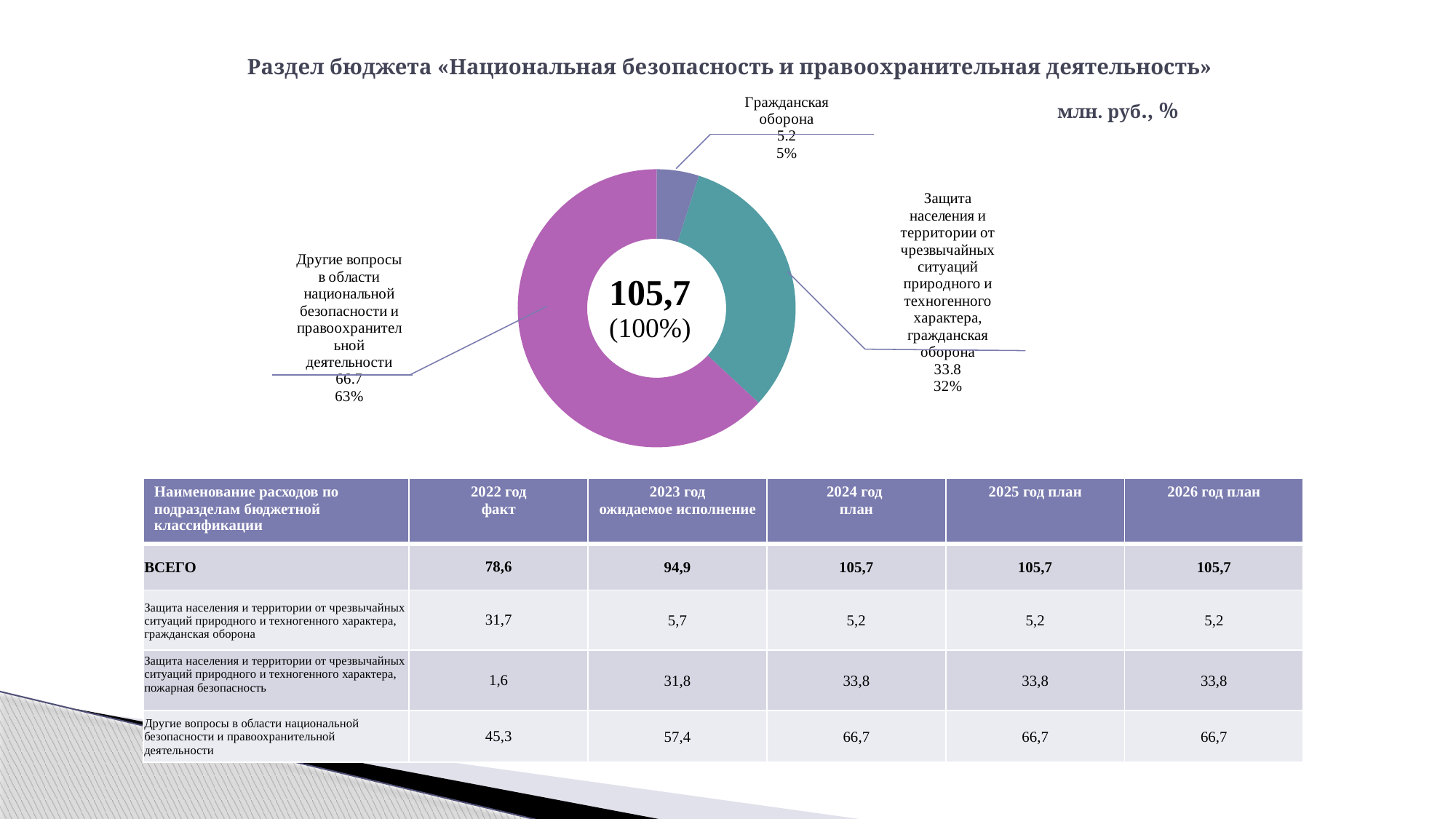
Which slice of the donut chart is the largest? Другие вопросы в области национальной безопасности и правоохранительной деятельности Which slice of the donut chart is the smallest? Гражданская оборона What kind of chart is shown on the slide? Pie (donut) chart What value is shown for the slice «Защита населения и территории от чрезвычайных ситуаций природного и техногенного характера, гражданская оборона»? 33.8 What is the difference between the values for «Другие вопросы в области национальной безопасности и правоохранительной деятельности» and «Защита населения и территории от чрезвычайных ситуаций природного и техногенного характера, гражданская оборона»? 32.9 What percentage share does the slice «Гражданская оборона» have? 5% What value is shown for the slice «Другие вопросы в области национальной безопасности и правоохранительной деятельности»? 66.7 What percentage share does the slice «Другие вопросы в области национальной безопасности и правоохранительной деятельности» have? 63% What total value is shown in the centre of the donut chart? 105,7 How many slices does the donut chart have? 3 What value is shown for the slice «Гражданская оборона»? 5.2 What units are indicated for the donut chart? млн. руб., %